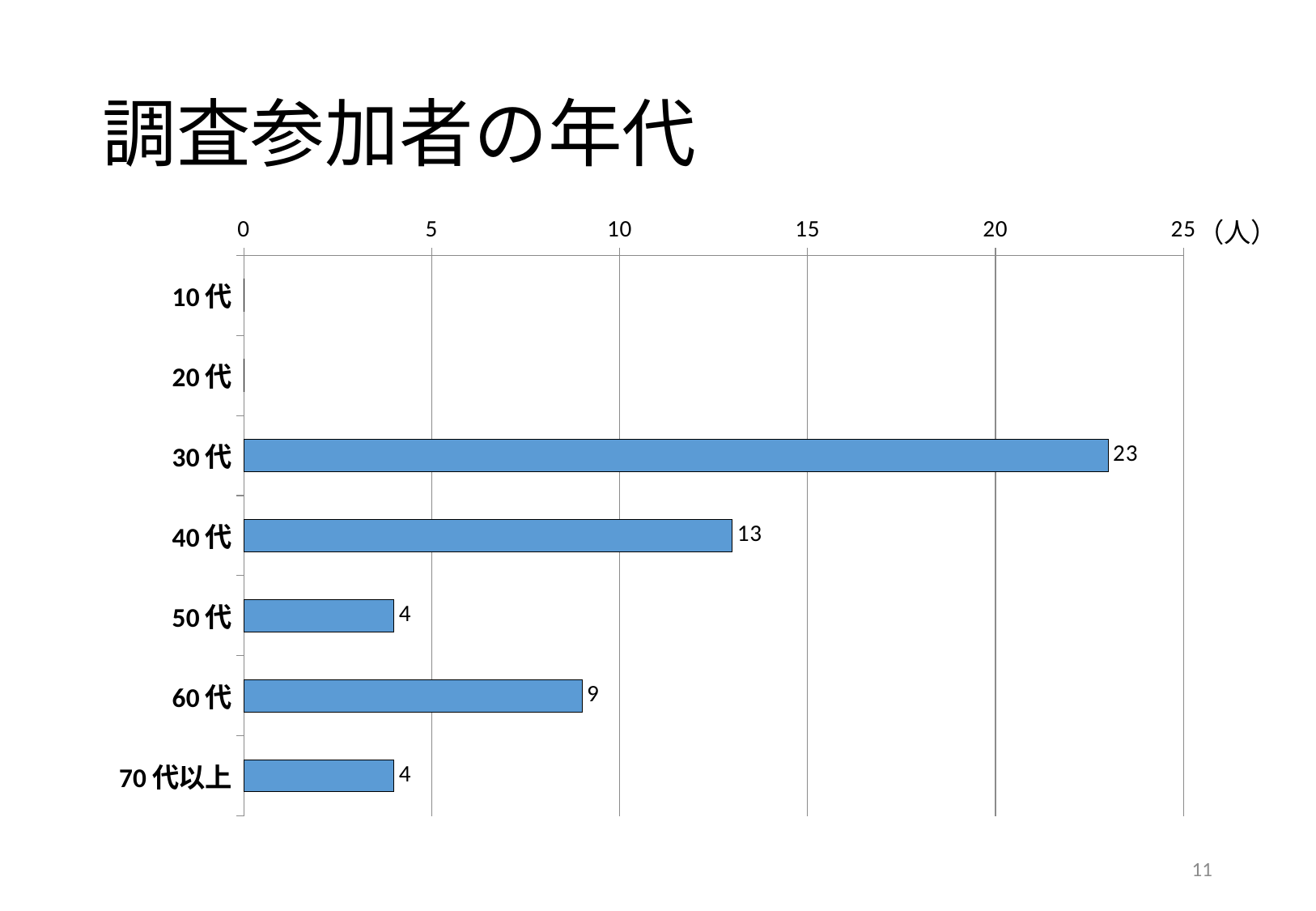
Is the value for 30代 greater or less than 20? greater Which age group has the highest value? 30代 What is the value for 60代? 9 What is the difference between the values for 60代 and 70代以上? 5 What is the value for 30代? 23 How many age categories are shown on the chart? 7 What is the value for 40代? 13 Which is larger, the value for 40代 or the value for 60代? 40代 What kind of chart is shown on the slide? bar chart What is the difference between the values for 30代 and 40代? 10 What is the value for 50代? 4 What is the title of the slide? 調査参加者の年代